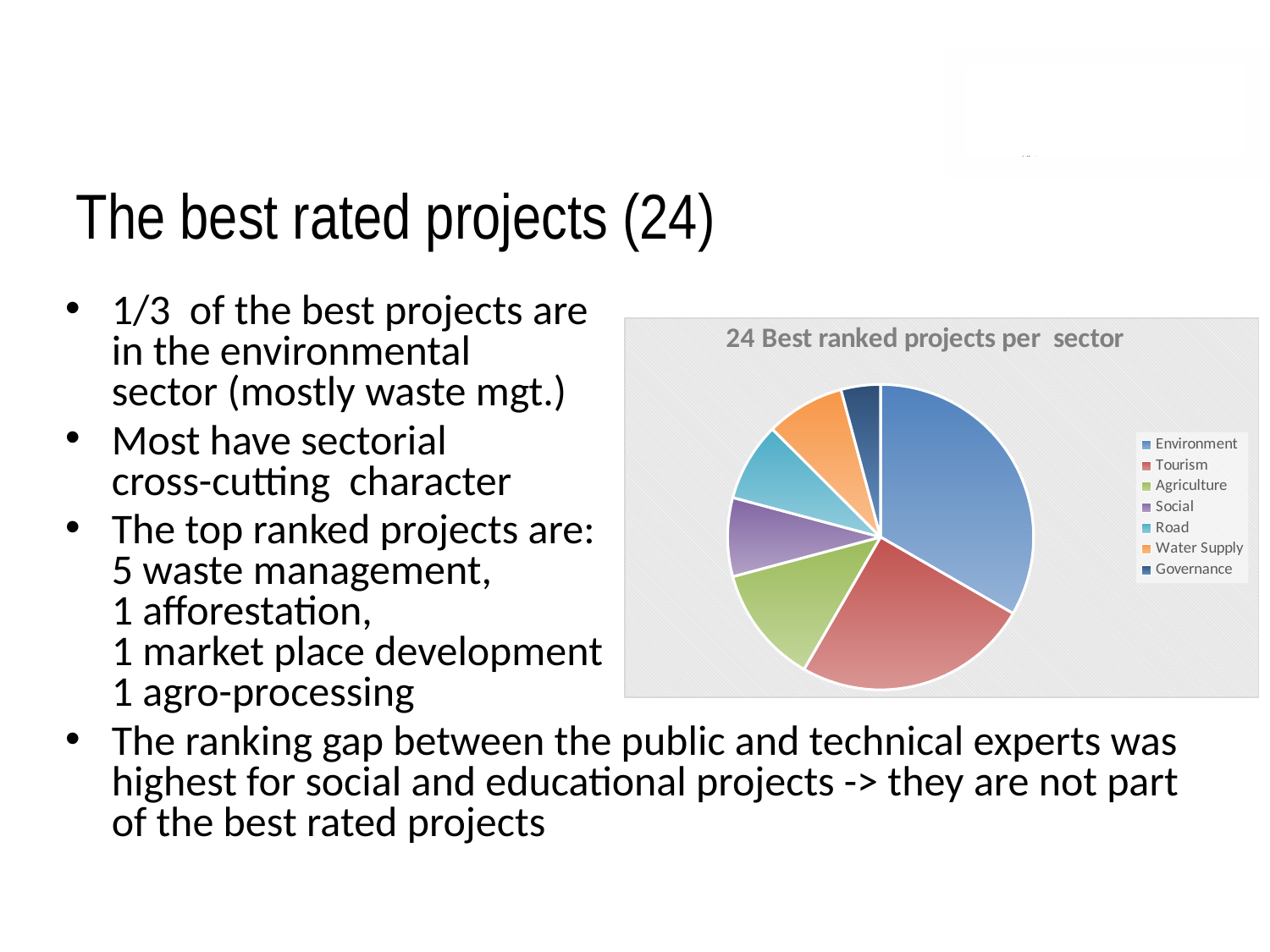
What is the title of the chart? 24 Best ranked projects per sector Which sector has the second largest slice of the pie? Tourism Which sector is shown in red in the pie chart? Tourism Which slice is larger, Environment or Tourism? Environment Which slice is larger, Water Supply or Governance? Water Supply Which sector has the smallest slice of the pie? Governance Which slice is larger, Agriculture or Governance? Agriculture What kind of chart is shown on the slide? pie chart How many sectors does the chart's legend list? 7 Which sector has the largest slice of the pie? Environment